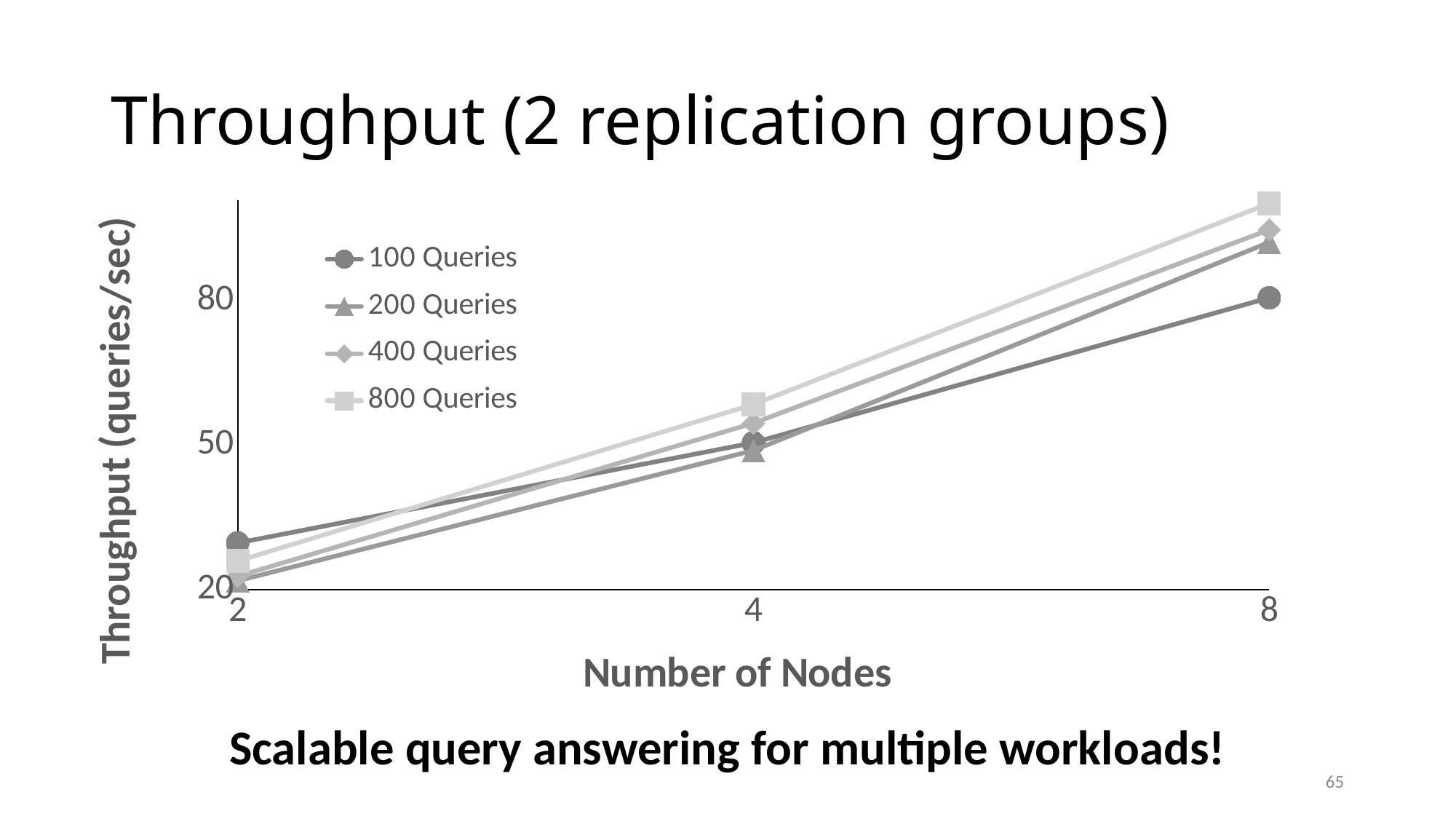
Is the throughput for 800 Queries at 8 nodes greater or less than 80? greater Does throughput rise or fall as the number of nodes increases? rises Is the throughput for 800 Queries at 4 nodes greater or less than 50? greater What kind of chart is shown on the slide? line chart How many node counts are plotted along the x axis? 3 Which series has the highest throughput at 8 nodes? 800 Queries What is the label of the y axis? Throughput (queries/sec) How many series does the legend list? 4 At 8 nodes, which is larger: the throughput for 800 Queries or for 100 Queries? 800 Queries Which series has the lowest throughput at 8 nodes? 100 Queries Is the throughput for 100 Queries at 2 nodes greater or less than 20? greater What is the label of the x axis? Number of Nodes